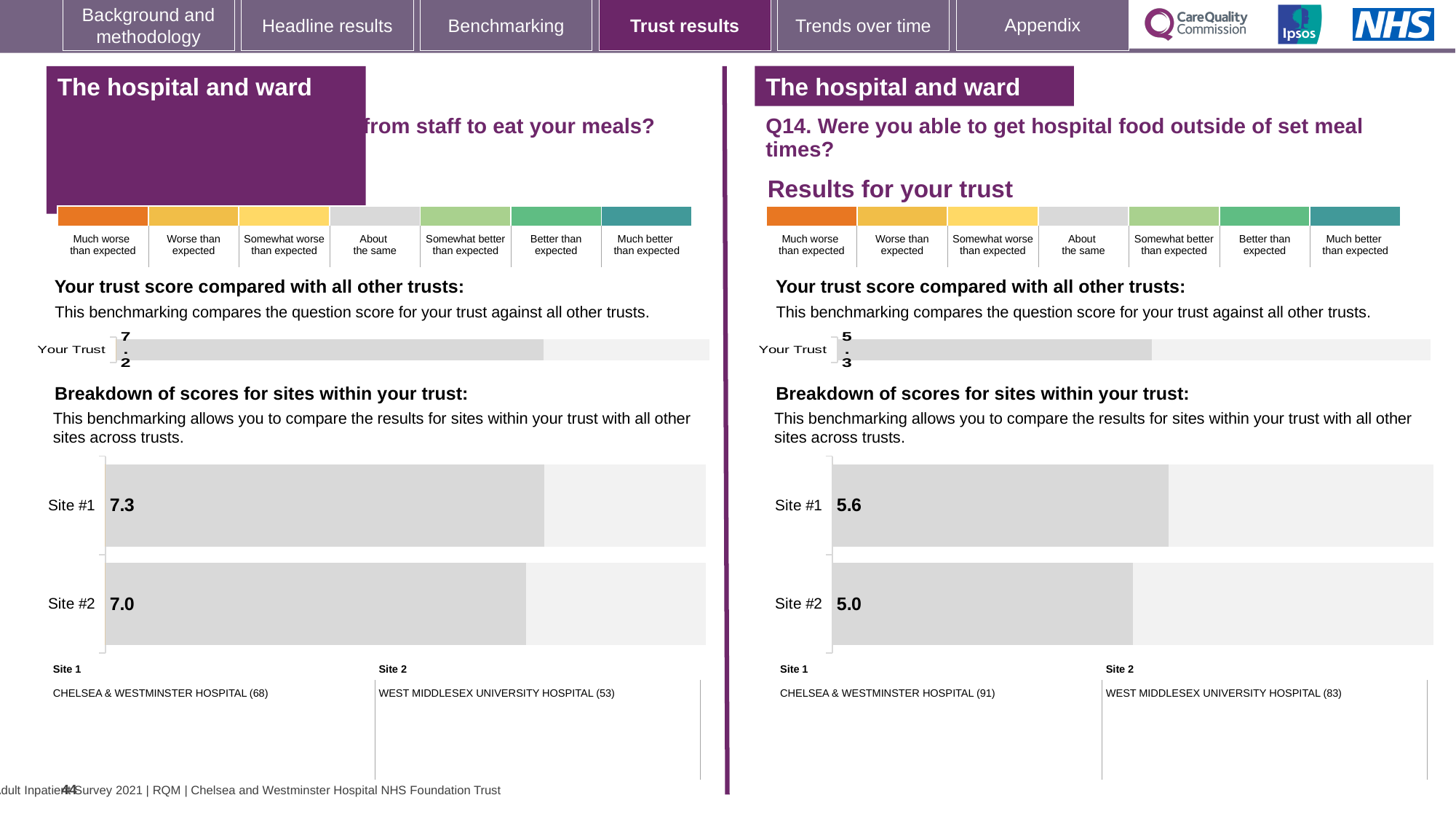
On the left-hand site breakdown chart, what is the score for Site #2? 7.0 On the right-hand (Q14) site breakdown chart, what is the score for Site #2? 5.0 On the right-hand (Q14) 'Your trust score compared with all other trusts' chart, what is the score for Your Trust? 5.3 How many sites are shown on the right-hand (Q14) site breakdown chart? 2 On the right-hand (Q14) site breakdown chart, what is the difference between the Site #1 and Site #2 scores? 0.6 On the right-hand (Q14) site breakdown chart, which site has the higher score? Site #1 On the left-hand site breakdown chart, which site has the lower score? Site #2 On the right-hand (Q14) site breakdown chart, what is the score for Site #1? 5.6 On the left-hand site breakdown chart, what is the difference between the Site #1 and Site #2 scores? 0.3 What type of chart is used for the site breakdown on the right-hand (Q14) side of the slide? Bar chart On the left-hand 'Your trust score compared with all other trusts' chart, what is the score for Your Trust? 7.2 On the left-hand site breakdown chart, what is the score for Site #1? 7.3